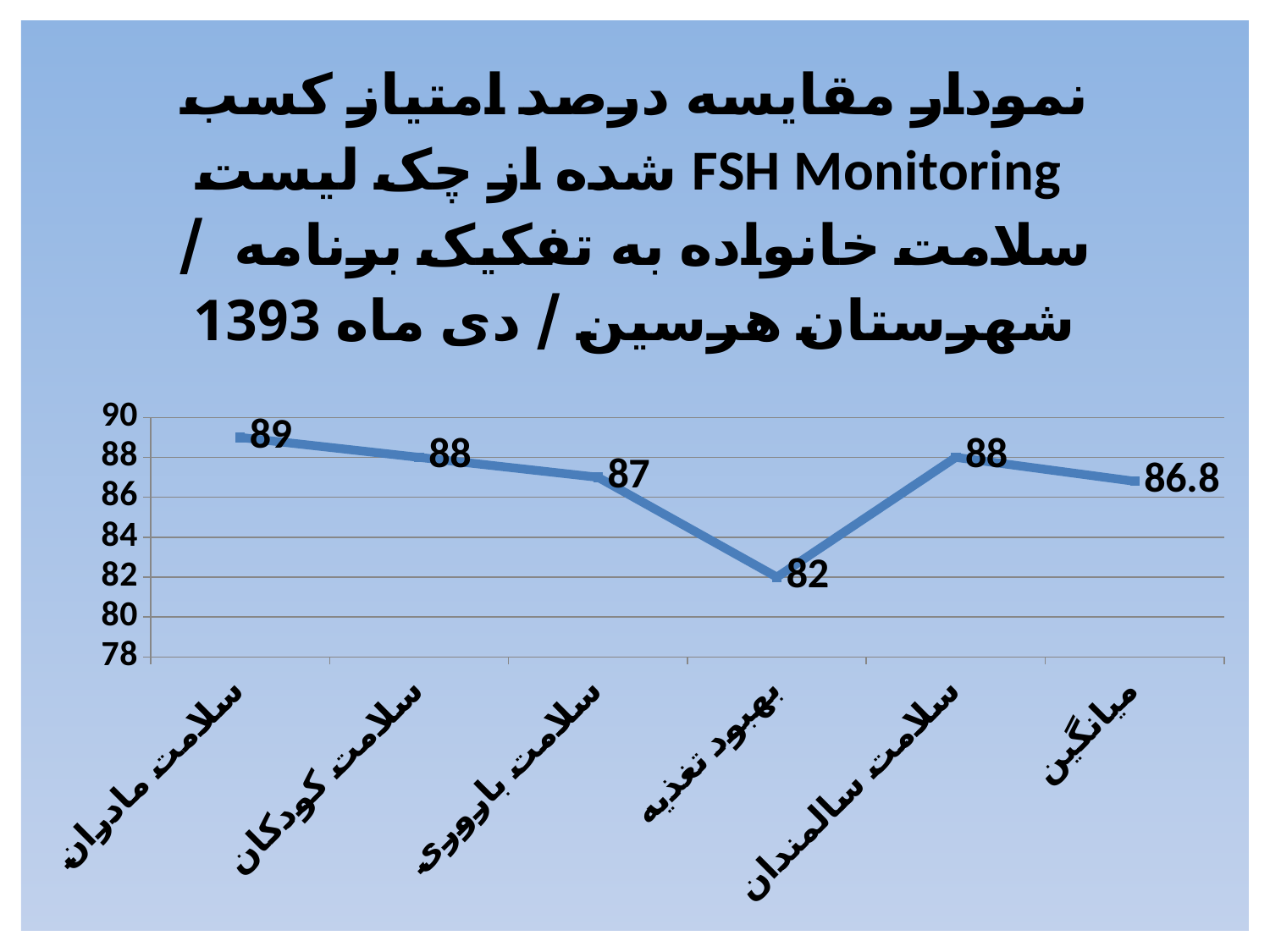
What is the value for سلامت مادران? 89 What is the difference between the values for سلامت مادران and بهبود تغذیه? 7 What is the value for میانگین? 86.8 How many categories are plotted on the x axis? 6 Which category has the highest value? سلامت مادران What is the value for سلامت باروری? 87 Which category has the lowest value? بهبود تغذیه Is the value for بهبود تغذیه greater or less than 84? less What is the difference between the values for سلامت سالمندان and میانگین? 1.2 Which is larger, the value for سلامت کودکان or the value for بهبود تغذیه? سلامت کودکان What is the value for بهبود تغذیه? 82 What type of chart is shown on the slide? line chart